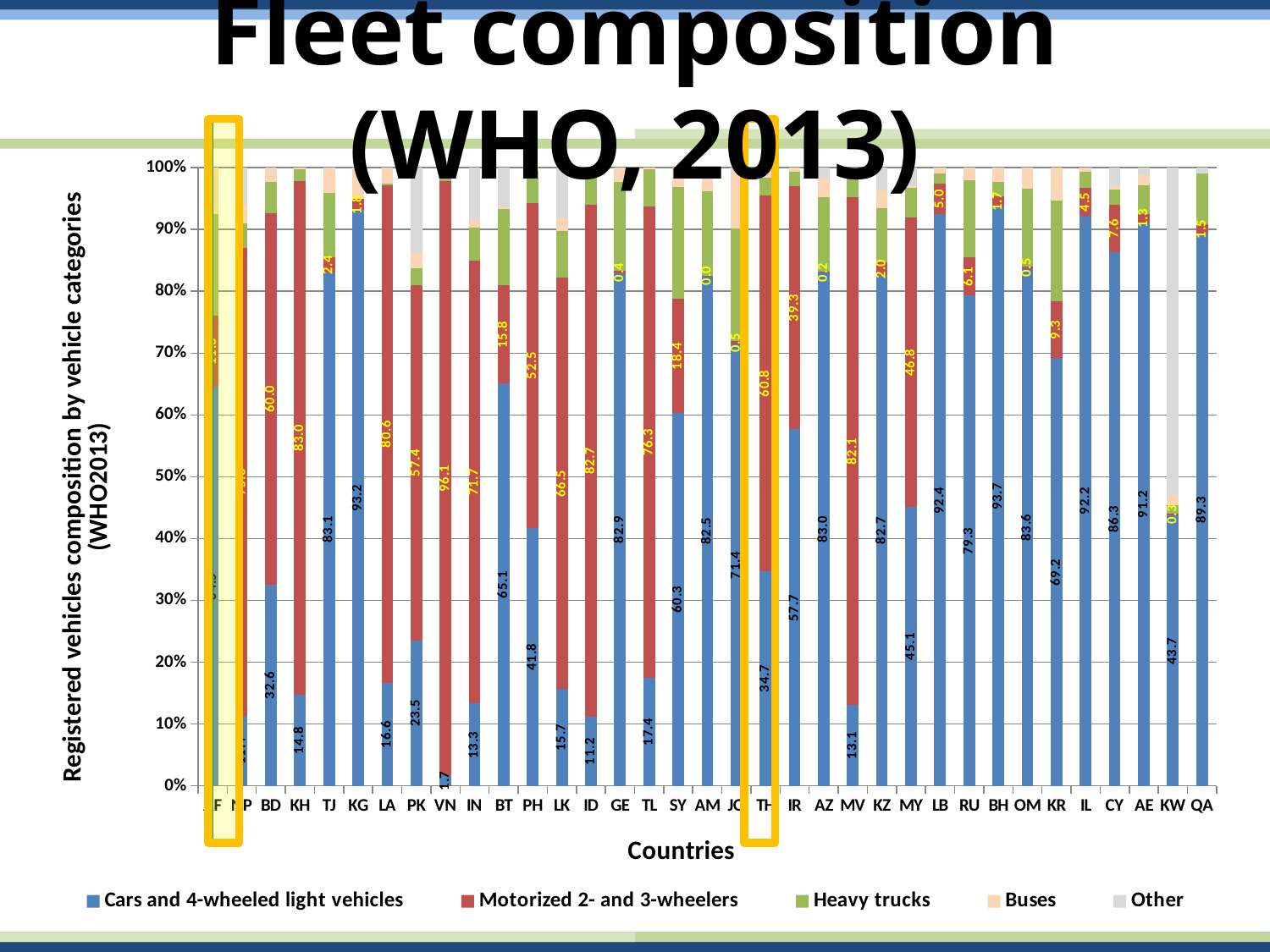
How many series does the legend list? 5 Which is larger for TH: the Cars and 4-wheeled light vehicles value or the Motorized 2- and 3-wheelers value? Motorized 2- and 3-wheelers What is the value for Cars and 4-wheeled light vehicles for TH? 34.7 Which country has the lowest value for Cars and 4-wheeled light vehicles? VN What is the value for Cars and 4-wheeled light vehicles for KG? 93.2 What is the difference between the Motorized 2- and 3-wheelers value (60.8) and the Cars and 4-wheeled light vehicles value (34.7) for TH? 26.1 Is the Cars and 4-wheeled light vehicles value for KW greater or less than 50%? less What is the value for Motorized 2- and 3-wheelers for VN? 96.1 What kind of chart is shown on the slide? Stacked bar chart Which country has the highest value for Motorized 2- and 3-wheelers? VN Which series is shown in red in the legend? Motorized 2- and 3-wheelers What is the value for Motorized 2- and 3-wheelers for KH? 83.0